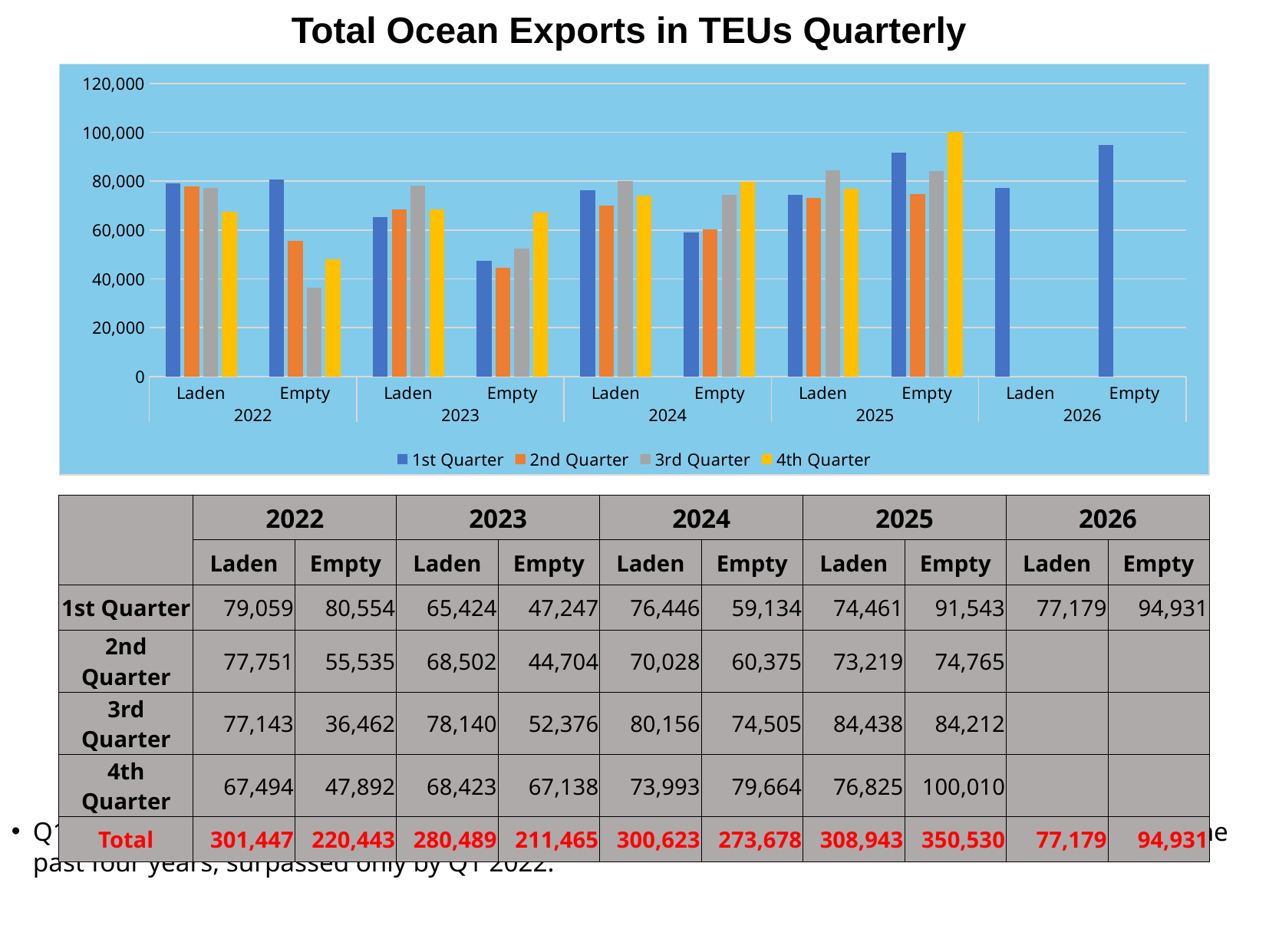
What is the total of the four quarters for Laden in 2024? 300,623 Which bar is the lowest in the chart? 3rd Quarter, Empty 2022 (36,462) How many series does the chart legend list? 4 Is the 1st Quarter value for Empty in 2026 greater or less than 80,000? greater What colour represents the 4th Quarter series in the chart? yellow What is the difference between the 1st Quarter and 2nd Quarter values for Laden in 2022? 1,308 How many years are shown along the x axis of the chart? 5 Do the Empty values for 2024 rise or fall from the 1st Quarter to the 4th Quarter? rise What kind of chart is shown on the slide? bar chart In 2023, which is larger for the 3rd Quarter: Laden or Empty? Laden Which bar is the highest in the chart? 4th Quarter, Empty 2025 (100,010) What is the 1st Quarter value for Empty in 2025? 91,543